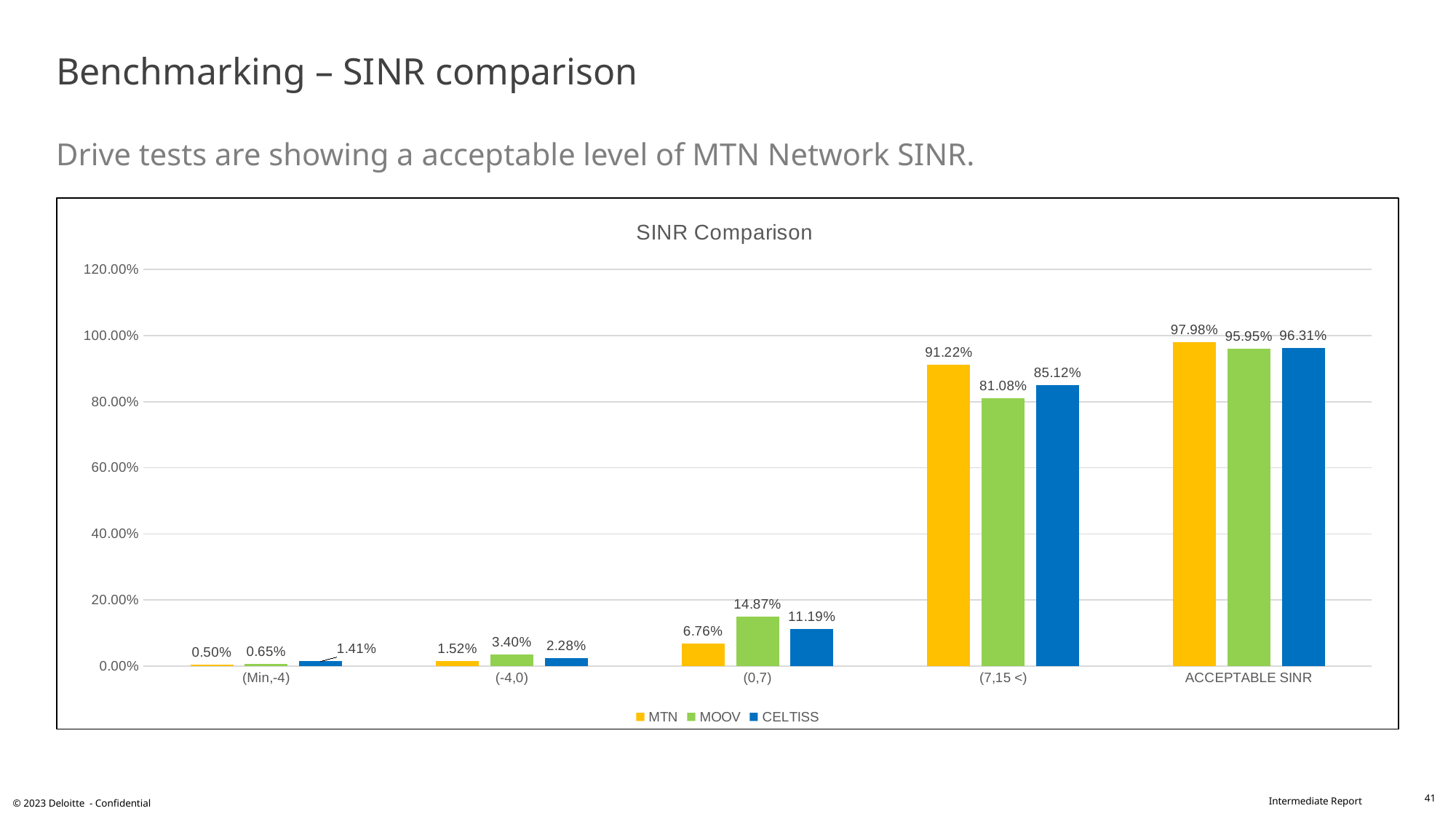
What is the MOOV value for the ACCEPTABLE SINR category? 95.95% What kind of chart is shown on the slide? Bar chart Which series has the highest value in the (0,7) category? MOOV Is the CELTISS value for the (7,15 <) category greater or less than 80.00%? greater Which is larger in the (-4,0) category, the MOOV value or the CELTISS value? MOOV What is the title of the chart? SINR Comparison How many categories are shown on the x axis? 5 What is the CELTISS value for the (0,7) category? 11.19% Which series has the lowest value in the (7,15 <) category? MOOV How many series does the legend list? 3 What is the MTN value for the (7,15 <) category? 91.22% What is the difference between the MTN and MOOV values in the (7,15 <) category? 10.14%